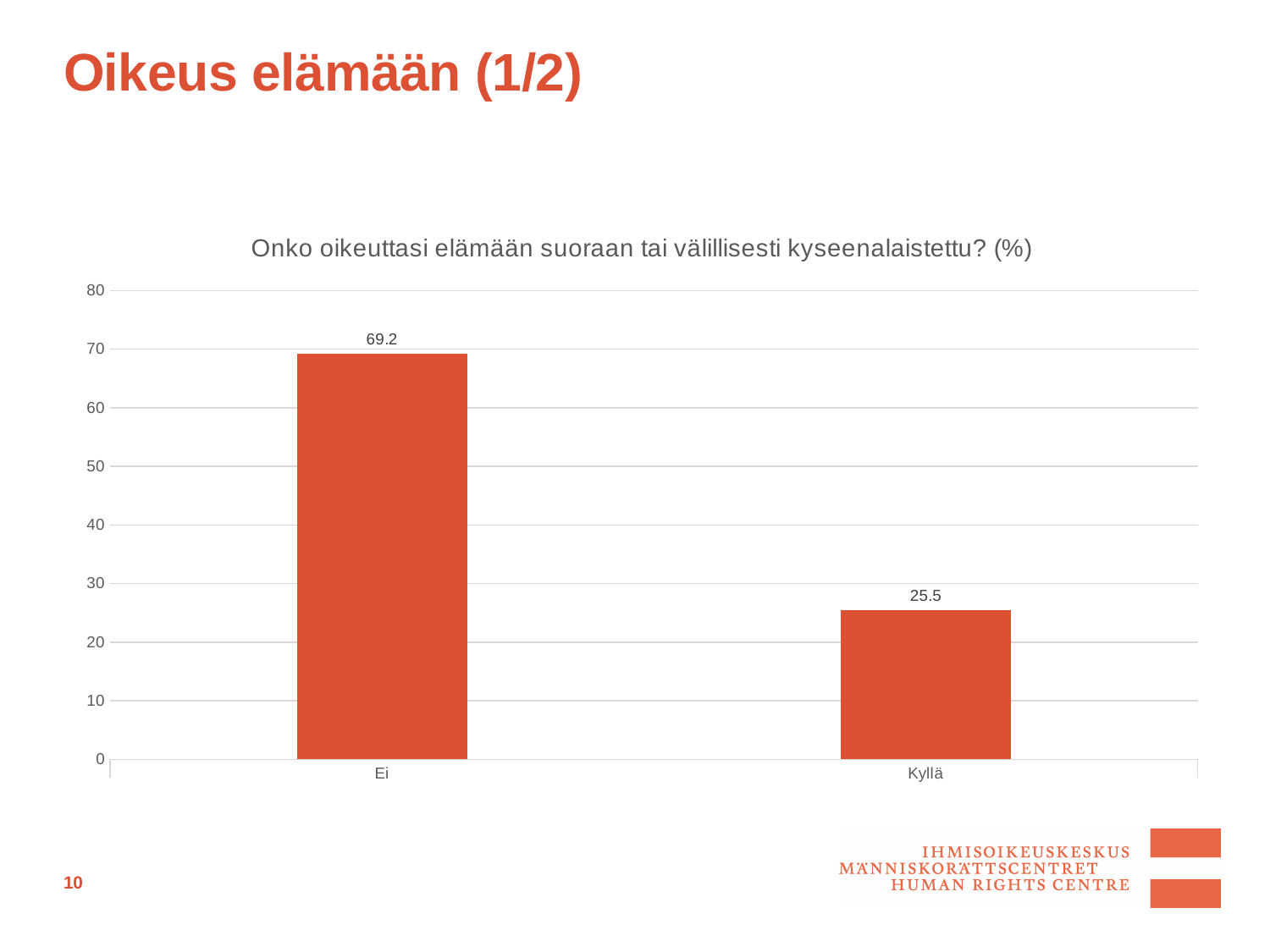
Which category has the lowest value? Kyllä What is the highest value shown on the y axis? 80 Is the value for Kyllä greater or less than 30? less How many categories are shown on the x axis? 2 What is the difference between the values for Ei and Kyllä? 43.7 Is the value for Ei greater or less than 60? greater What kind of chart is shown on the slide? bar chart Which is larger, the value for Ei or the value for Kyllä? Ei What is the value for Ei? 69.2 What is the title of the chart? Onko oikeuttasi elämään suoraan tai välillisesti kyseenalaistettu? (%) What is the value for Kyllä? 25.5 Which category has the highest value? Ei